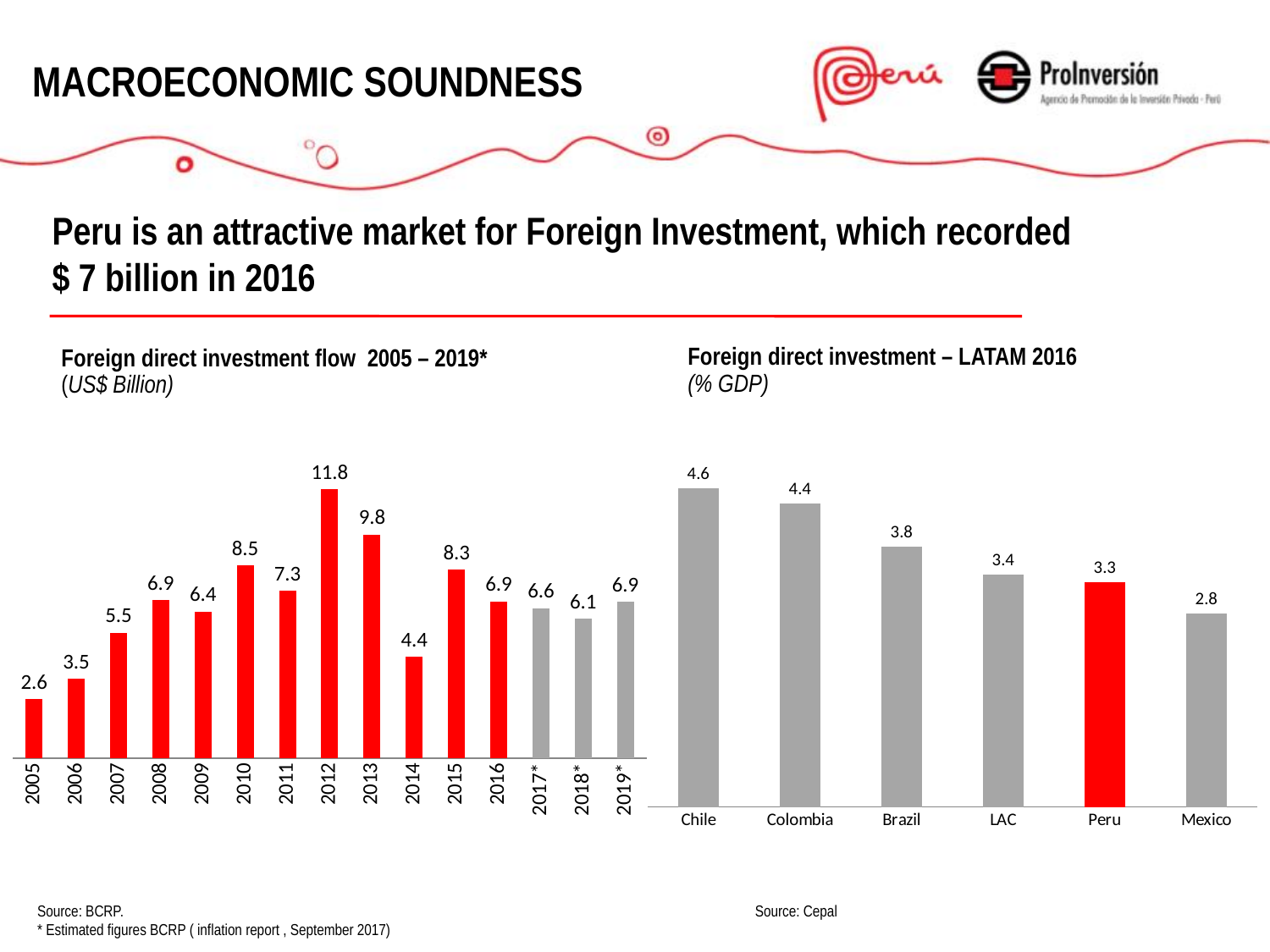
In the 'Foreign direct investment flow 2005 – 2019*' chart, what is the value for 2016? 6.9 In the 'Foreign direct investment flow 2005 – 2019*' chart, what is the value for 2012? 11.8 In the 'Foreign direct investment – LATAM 2016' chart, which category has the lowest value? Mexico In the 'Foreign direct investment – LATAM 2016' chart, what is the difference between the values for Chile and Peru? 1.3 In the 'Foreign direct investment – LATAM 2016' chart, which country has the highest value? Chile In the 'Foreign direct investment flow 2005 – 2019*' chart, which year has the highest value? 2012 In the 'Foreign direct investment flow 2005 – 2019*' chart, how many years are shown on the x axis? 15 What type of chart is the 'Foreign direct investment – LATAM 2016' chart? bar chart In the 'Foreign direct investment flow 2005 – 2019*' chart, is the value for 2015 larger or smaller than the value for 2011? larger In the 'Foreign direct investment flow 2005 – 2019*' chart, what is the difference between the values for 2013 and 2014? 5.4 In the 'Foreign direct investment – LATAM 2016' chart, what is the value for Peru? 3.3 In the 'Foreign direct investment flow 2005 – 2019*' chart, which year has the lowest value? 2005